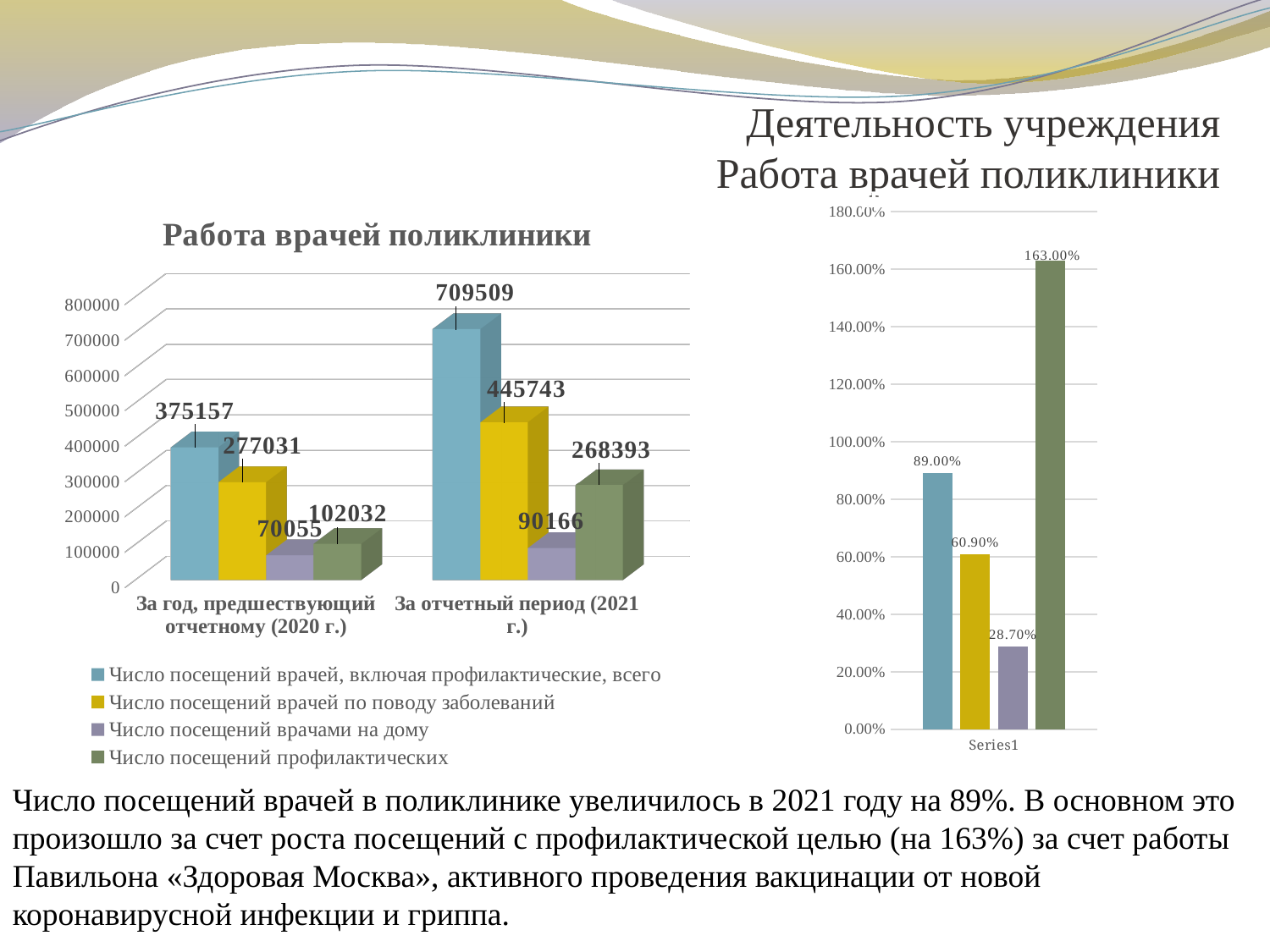
How many series does the legend of the left chart titled 'Работа врачей поликлиники' list? 4 In the right chart, what is the value of the shortest (purple) bar? 28.70% In the left chart titled 'Работа врачей поликлиники', which series has the lowest value for 'За год, предшествующий отчетному (2020 г.)'? Число посещений врачами на дому In the right chart, what is the difference between the first (blue) bar and the second (yellow) bar? 28.10% In the left chart titled 'Работа врачей поликлиники', what is the difference between 'Число посещений врачей, включая профилактические, всего' in 2021 and in 2020? 334352 In the left chart titled 'Работа врачей поликлиники', which is larger: 'Число посещений врачей по поводу заболеваний' in 2021 or 'Число посещений врачей, включая профилактические, всего' in 2020? Число посещений врачей по поводу заболеваний in 2021 What kind of chart is the left chart titled 'Работа врачей поликлиники'? bar chart How many categories are shown on the x axis of the left chart titled 'Работа врачей поликлиники'? 2 In the left chart titled 'Работа врачей поликлиники', what is the value of 'Число посещений врачей, включая профилактические, всего' for 'За отчетный период (2021 г.)'? 709509 In the right chart, what is the value of the tallest (dark green) bar? 163.00% In the left chart titled 'Работа врачей поликлиники', what is the value of 'Число посещений профилактических' for 'За отчетный период (2021 г.)'? 268393 In the left chart titled 'Работа врачей поликлиники', what is the value of 'Число посещений врачами на дому' for 'За год, предшествующий отчетному (2020 г.)'? 70055